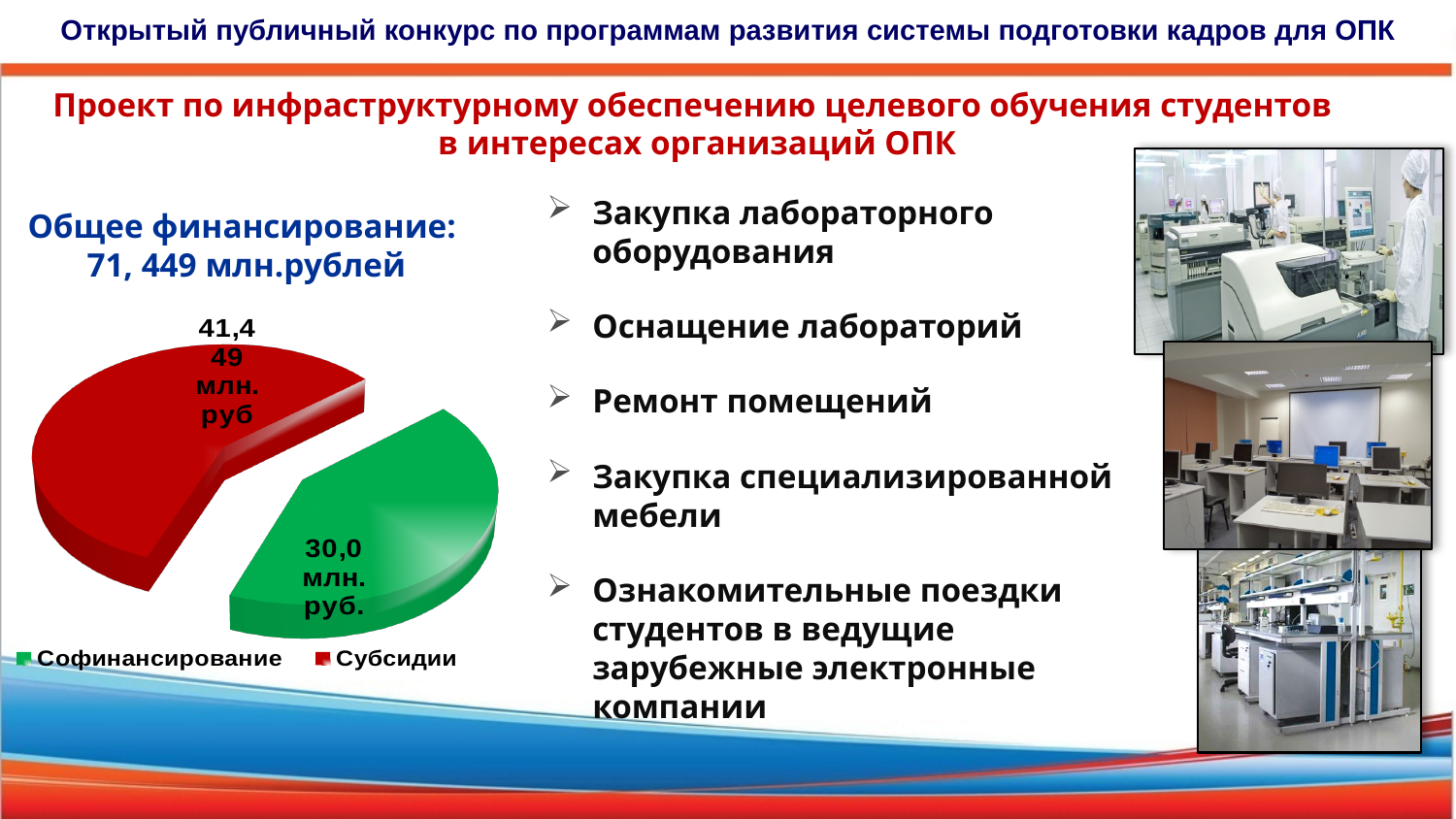
What is the value shown for the Софинансирование slice of the pie chart? 30,0 млн. руб. What colour is the Субсидии slice in the pie chart? red Which slice of the pie chart is larger, Софинансирование or Субсидии? Субсидии How many slices does the pie chart have? 2 What kind of chart is shown on the slide? pie chart Which category has the smallest slice in the pie chart? Софинансирование How many entries does the legend of the pie chart list? 2 Which category has the largest slice in the pie chart? Субсидии What colour is the Софинансирование slice in the pie chart? green